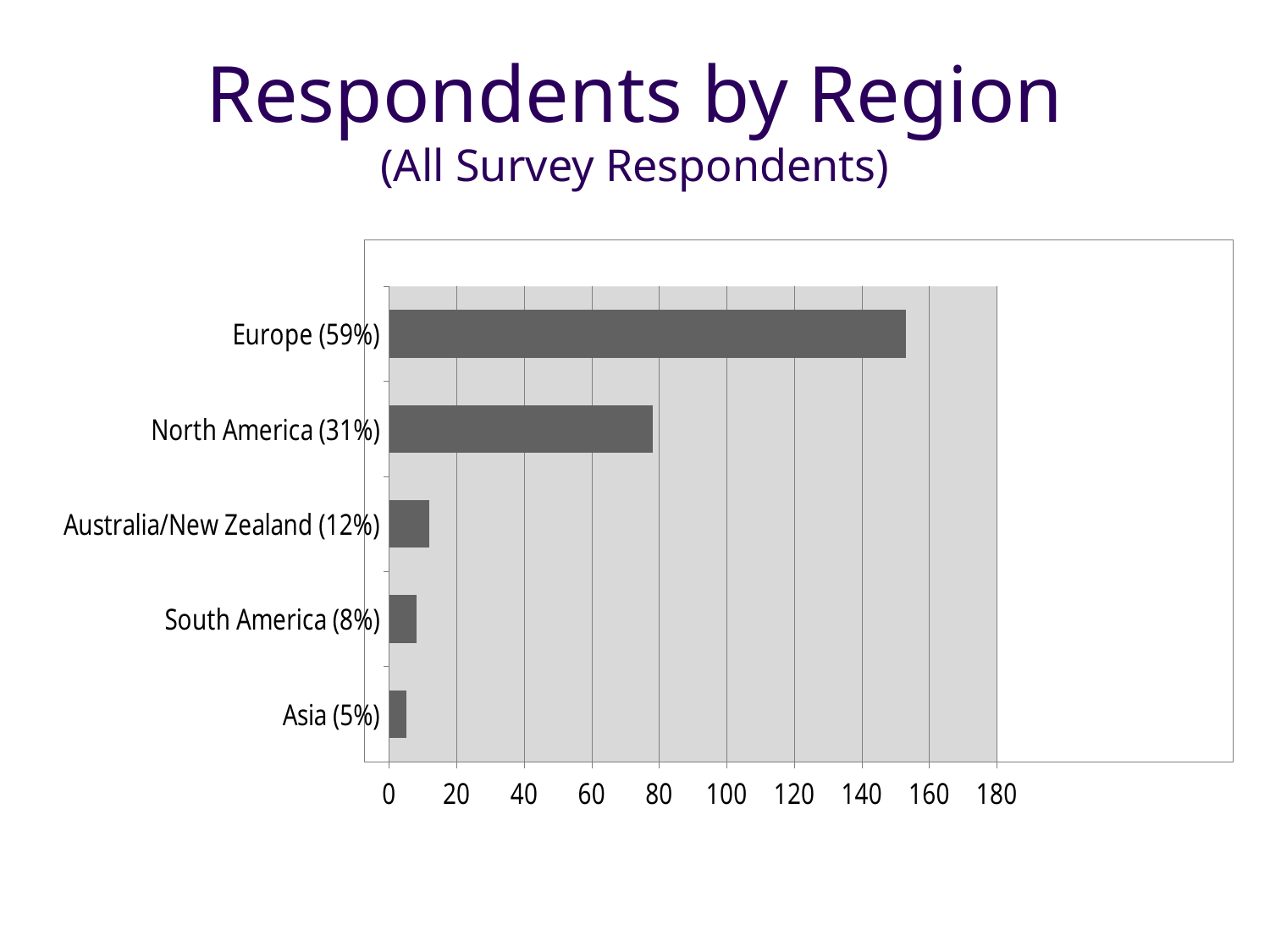
Is the value for Europe greater or less than 140? greater Is the value for North America greater or less than 60? greater Which region has the lowest number of respondents? Asia Is the value for Australia/New Zealand greater or less than 20? less Which has more respondents, North America or South America? North America How many regions are shown in the chart? 5 What is the title of the chart on the slide? Respondents by Region (All Survey Respondents) What kind of chart is shown on the slide? bar chart Which region has the highest number of respondents? Europe What percentage of respondents is shown in the label for Europe? 59% What percentage of respondents is shown in the label for Asia? 5%